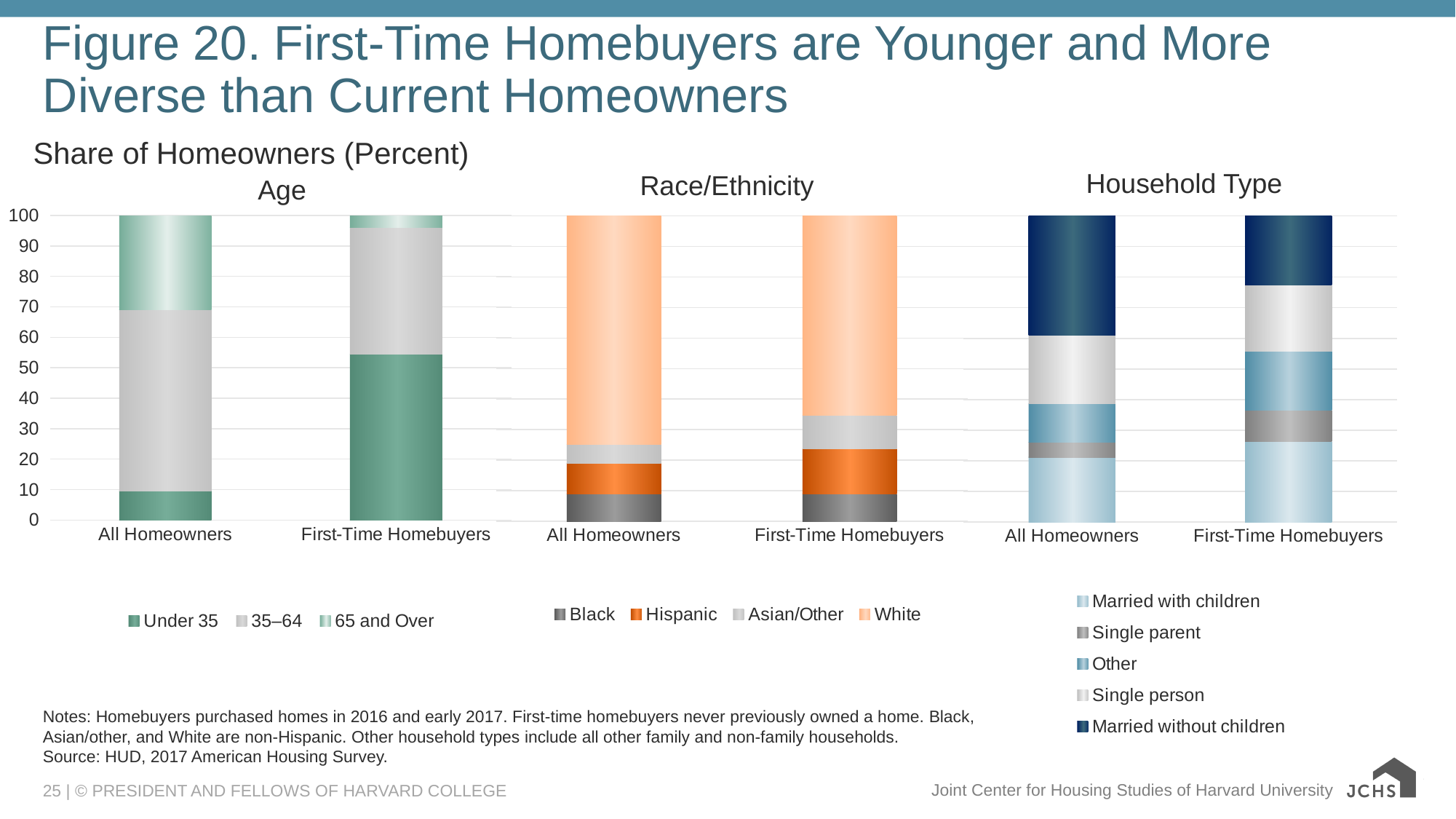
In the Household Type chart, is the Married without children share for All Homeowners greater or less than 30? greater In the Age chart, which category has the larger 65 and Over share, All Homeowners or First-Time Homebuyers? All Homeowners In the Household Type chart, which category has the larger Married without children share, All Homeowners or First-Time Homebuyers? All Homeowners How many categories are shown on the x axis of the Race/Ethnicity chart? 2 How many series does the legend of the Age chart list? 3 What kind of chart is the Age chart? stacked bar chart How many series does the legend of the Household Type chart list? 5 In the Age chart, which category has the larger Under 35 share, All Homeowners or First-Time Homebuyers? First-Time Homebuyers What is the unit label shown above the charts? Share of Homeowners (Percent) In the Age chart, is the Under 35 share for First-Time Homebuyers greater or less than 50? greater